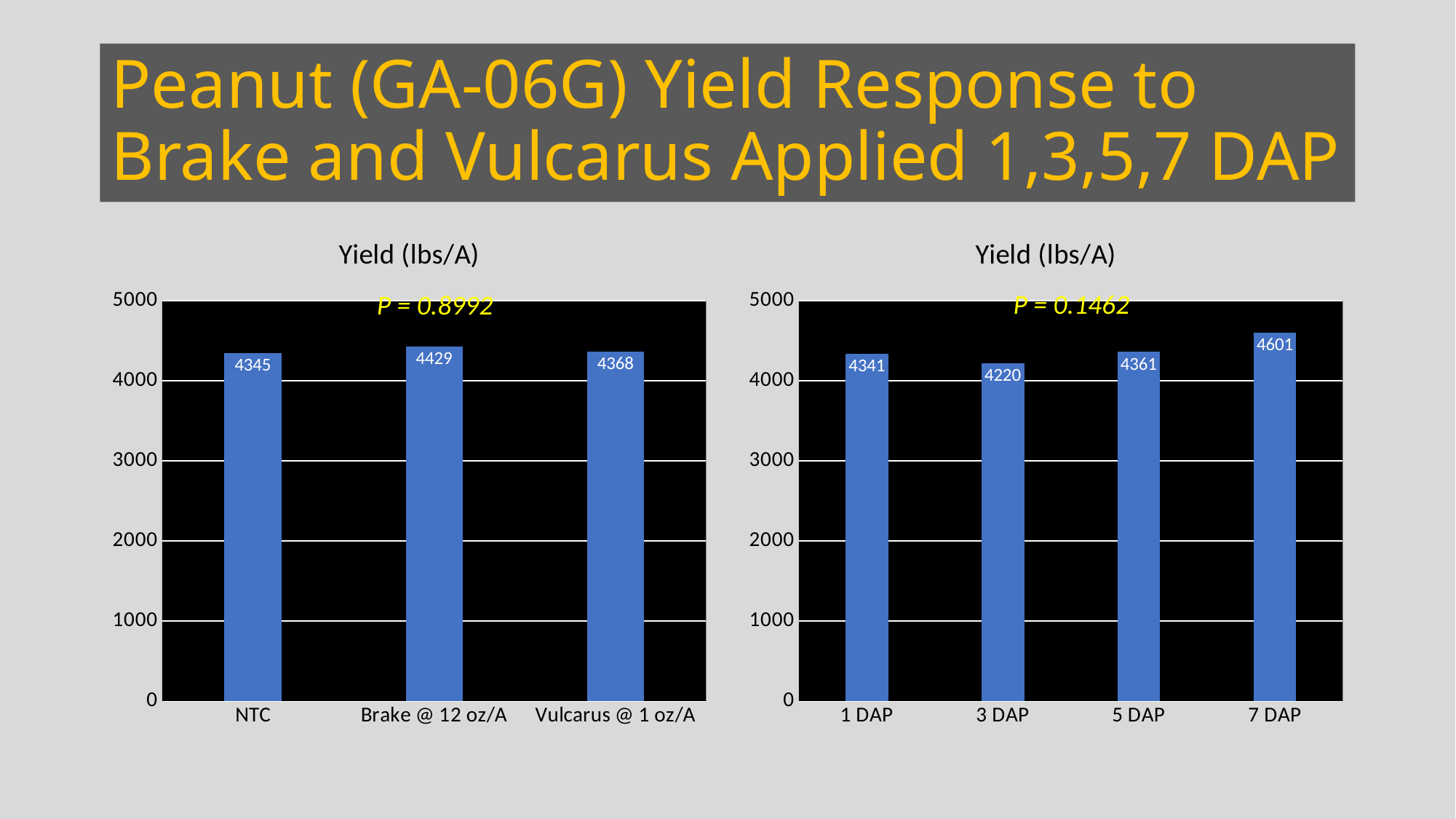
In the right chart, what is the difference in yield between 7 DAP and 3 DAP? 381 In the right chart, which application timing has the lowest yield? 3 DAP In the left chart, what is the yield for Brake @ 12 oz/A? 4429 In the left chart, what is the yield for NTC? 4345 In the right chart, is the yield for 3 DAP greater or less than 4000? greater How many categories are shown in the right chart? 4 In the right chart, what is the yield for 3 DAP? 4220 In the right chart, which application timing has the highest yield? 7 DAP What type of chart is the left chart? Bar chart In the right chart, what is the yield for 7 DAP? 4601 In the left chart, which treatment has the highest yield? Brake @ 12 oz/A In the left chart, what is the difference in yield between Brake @ 12 oz/A and NTC? 84